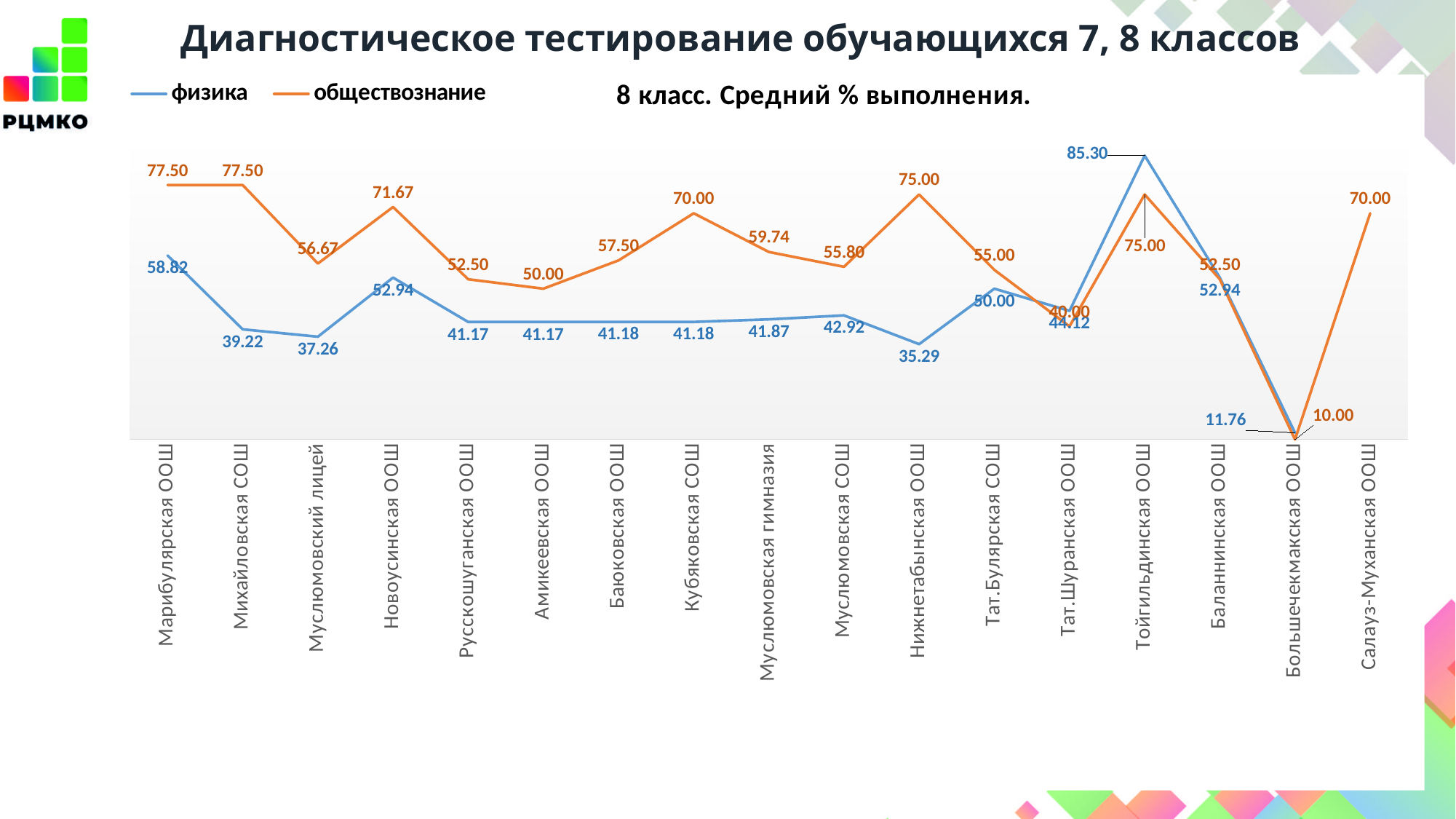
Which school has the lowest обществознание value? Большечекмакская ООШ Which school has the highest физика value? Тойгильдинская ООШ What is the физика value for Тойгильдинская ООШ? 85.30 What is the физика value for Михайловская СОШ? 39.22 What is the обществознание value for Нижнетабынская ООШ? 75.00 What is the обществознание value for Салауз-Муханская ООШ? 70.00 What is the difference between the физика and обществознание values for Тойгильдинская ООШ? 10.30 For Нижнетабынская ООШ, which is larger: физика or обществознание? обществознание How many schools are shown on the x axis? 17 How many series does the legend list? 2 What kind of chart is shown on the slide? line chart What is the difference between the обществознание and физика values for Марибулярская ООШ? 18.68